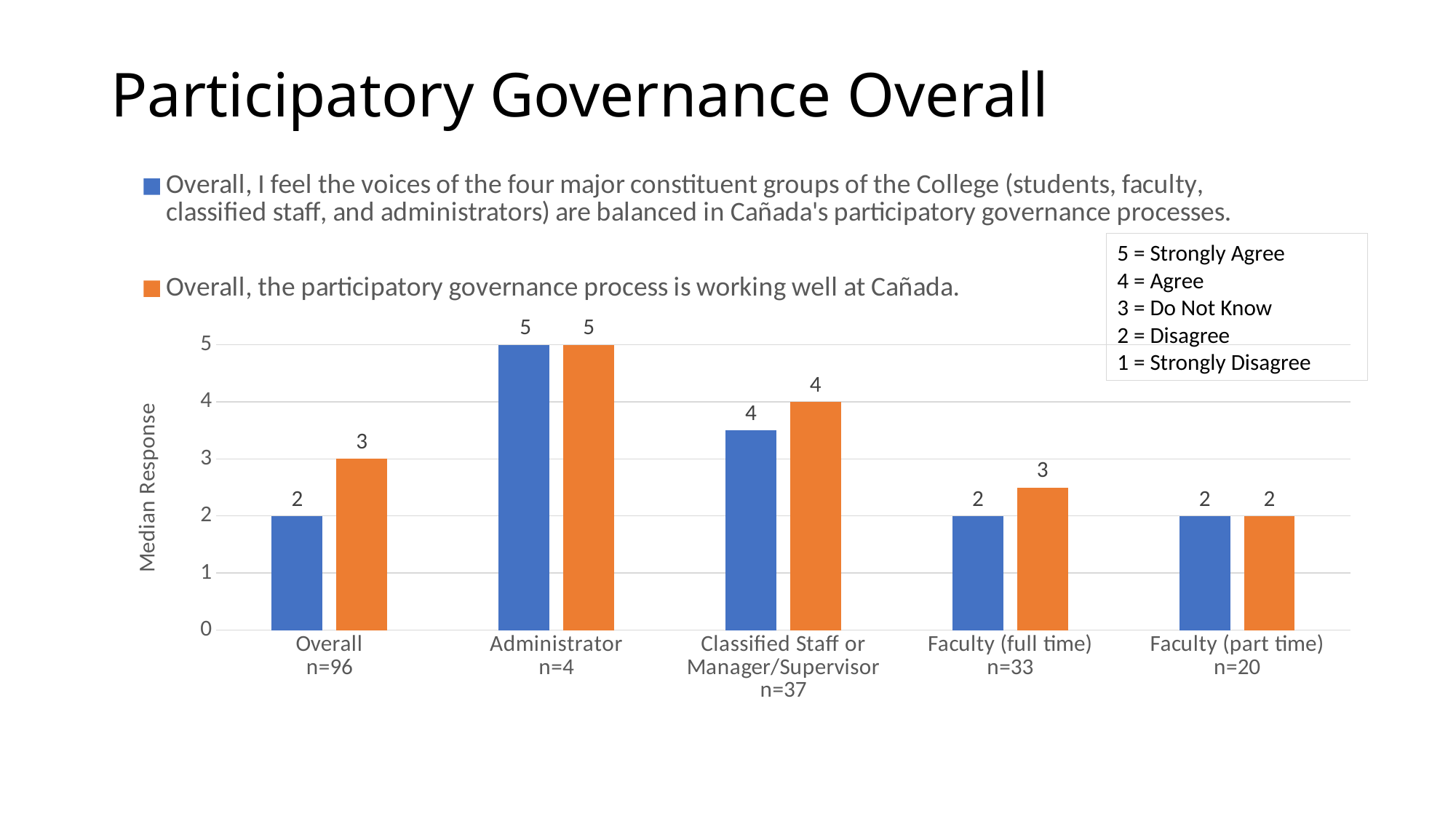
For Overall (n=96), which statement has the larger median response: the voices are balanced statement or the process is working well statement? The process is working well statement What type of chart is shown on the slide? Bar chart What is the difference between the Administrator median response and the Overall median response for the statement that the participatory governance process is working well at Cañada? 2 What is the label on the vertical axis of the chart? Median Response Which category has the highest median response for the statement that the voices of the four major constituent groups are balanced? Administrator n=4 What is the median response for Administrator (n=4) on the statement that the participatory governance process is working well at Cañada? 5 Which category has the highest median response for the statement that the participatory governance process is working well at Cañada? Administrator n=4 Is the median response for Administrator (n=4) on the voices are balanced statement greater or less than 4? greater What is the median response for Faculty (part time) (n=20) on the statement that the participatory governance process is working well at Cañada? 2 How many series does the legend list? 2 How many categories are shown on the x axis? 5 What is the median response for Overall (n=96) on the statement that the voices of the four major constituent groups are balanced? 2